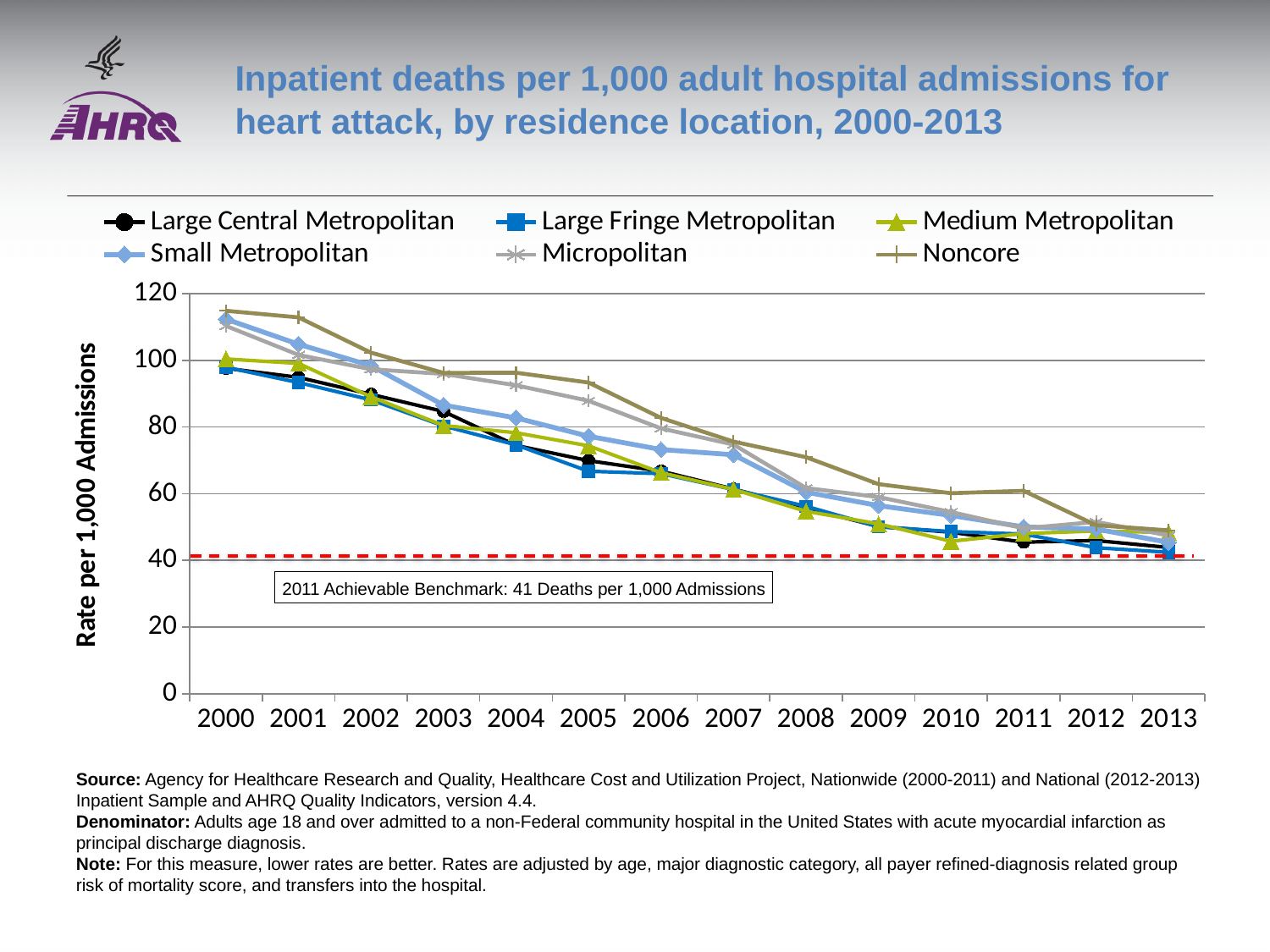
What is the label of the y axis? Rate per 1,000 Admissions How many series does the legend list? 6 In 2011, which is larger: the value for Noncore or the value for Large Central Metropolitan? Noncore How many years are shown along the x axis? 14 In 2008, which is larger: the value for Noncore or the value for Medium Metropolitan? Noncore Is the value for Micropolitan in 2005 greater or less than 80? greater Is the value for Medium Metropolitan in 2010 greater or less than 60? less Is the value for Large Central Metropolitan in 2013 greater or less than 60? less What kind of chart is shown on the slide? line chart What is the 2011 achievable benchmark shown on the chart? 41 Deaths per 1,000 Admissions Do the rates for Large Central Metropolitan rise or fall from 2000 to 2013? fall